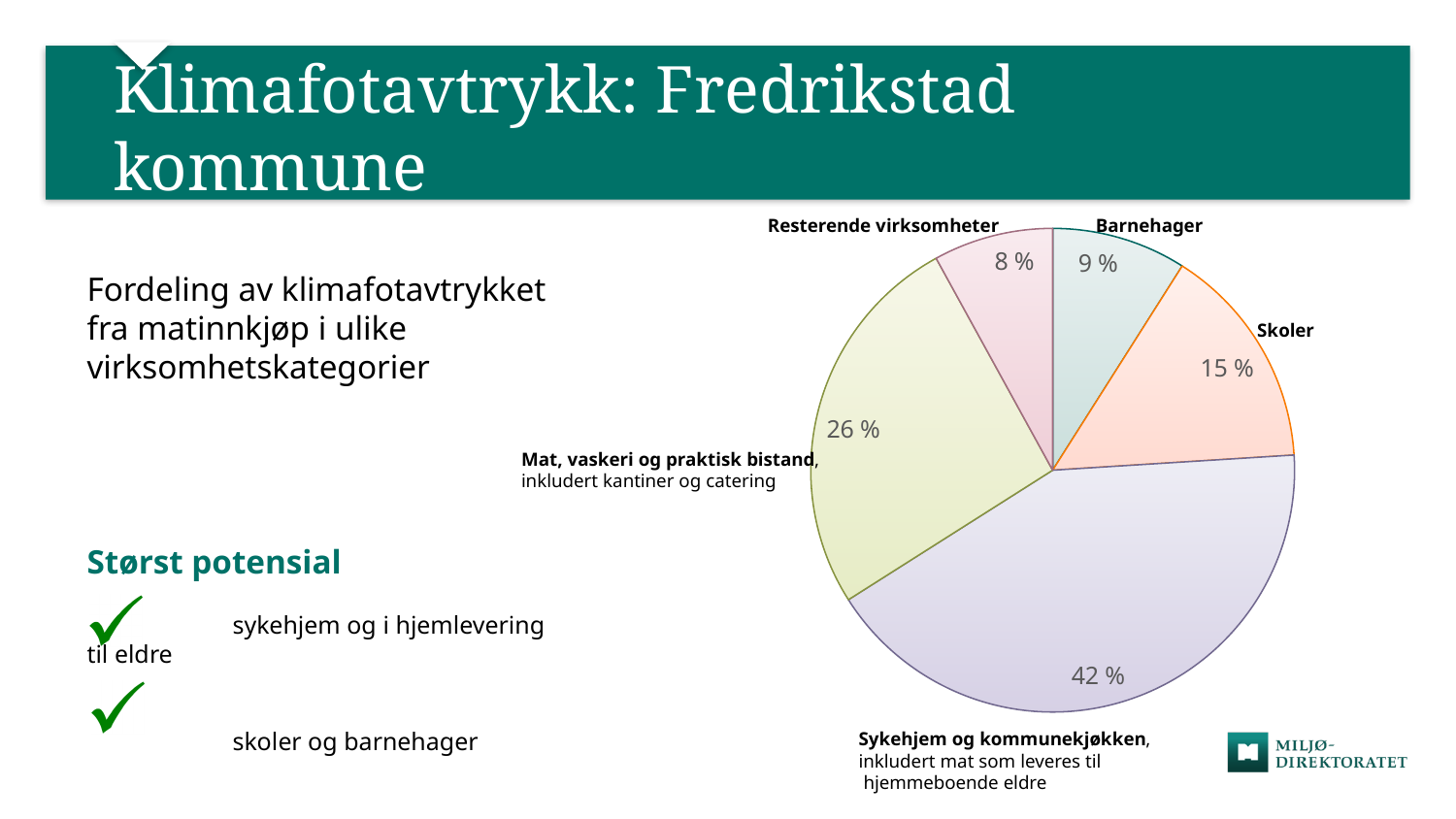
What share of the pie does Sykehjem og kommunekjøkken have? 42 % What is the value shown for Barnehager? 9 % What share of the pie does Skoler have? 15 % What kind of chart is shown on the slide? pie chart Which category has the smallest slice of the pie? Resterende virksomheter Which category has the largest slice of the pie? Sykehjem og kommunekjøkken What is the difference in percentage points between Sykehjem og kommunekjøkken and Mat, vaskeri og praktisk bistand? 16 % What is the value shown for Resterende virksomheter? 8 % What is the combined share of Skoler and Barnehager? 24 % What is the value shown for Mat, vaskeri og praktisk bistand? 26 % Which is larger, the slice for Skoler or the slice for Barnehager? Skoler How many slices does the pie chart have? 5